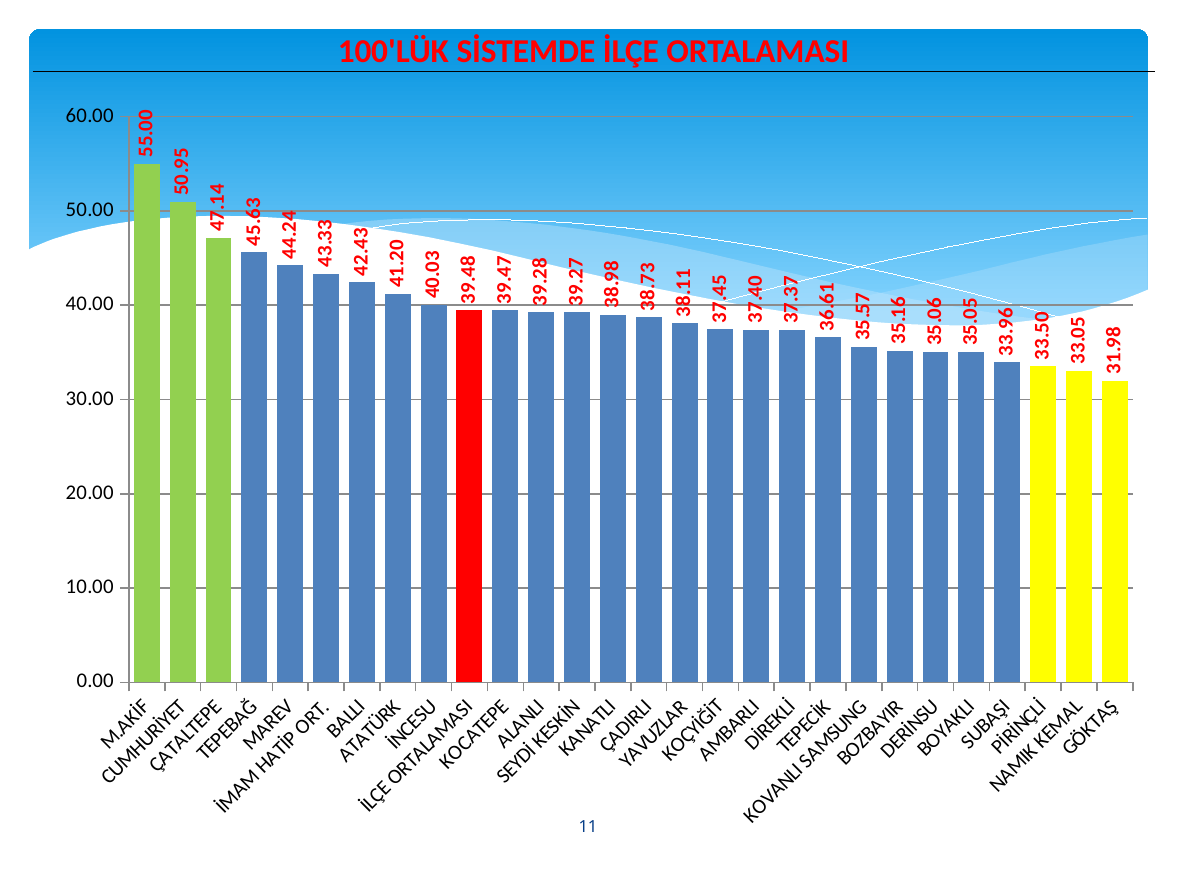
Which category has the highest value? M.AKİF Which category has the lowest value? GÖKTAŞ What is the value for İLÇE ORTALAMASI? 39.48 What is the title of the chart? 100'LÜK SİSTEMDE İLÇE ORTALAMASI What is the value for GÖKTAŞ? 31.98 What is the value for TEPEBAĞ? 45.63 What is the value for M.AKİF? 55.00 Which is larger, the value for ÇATALTEPE or the value for MAREV? ÇATALTEPE How many categories are shown on the x axis? 28 What is the difference between the values for M.AKİF and CUMHURİYET? 4.05 What kind of chart is shown on the slide? bar chart Is the value for CUMHURİYET greater or less than 50.00? greater